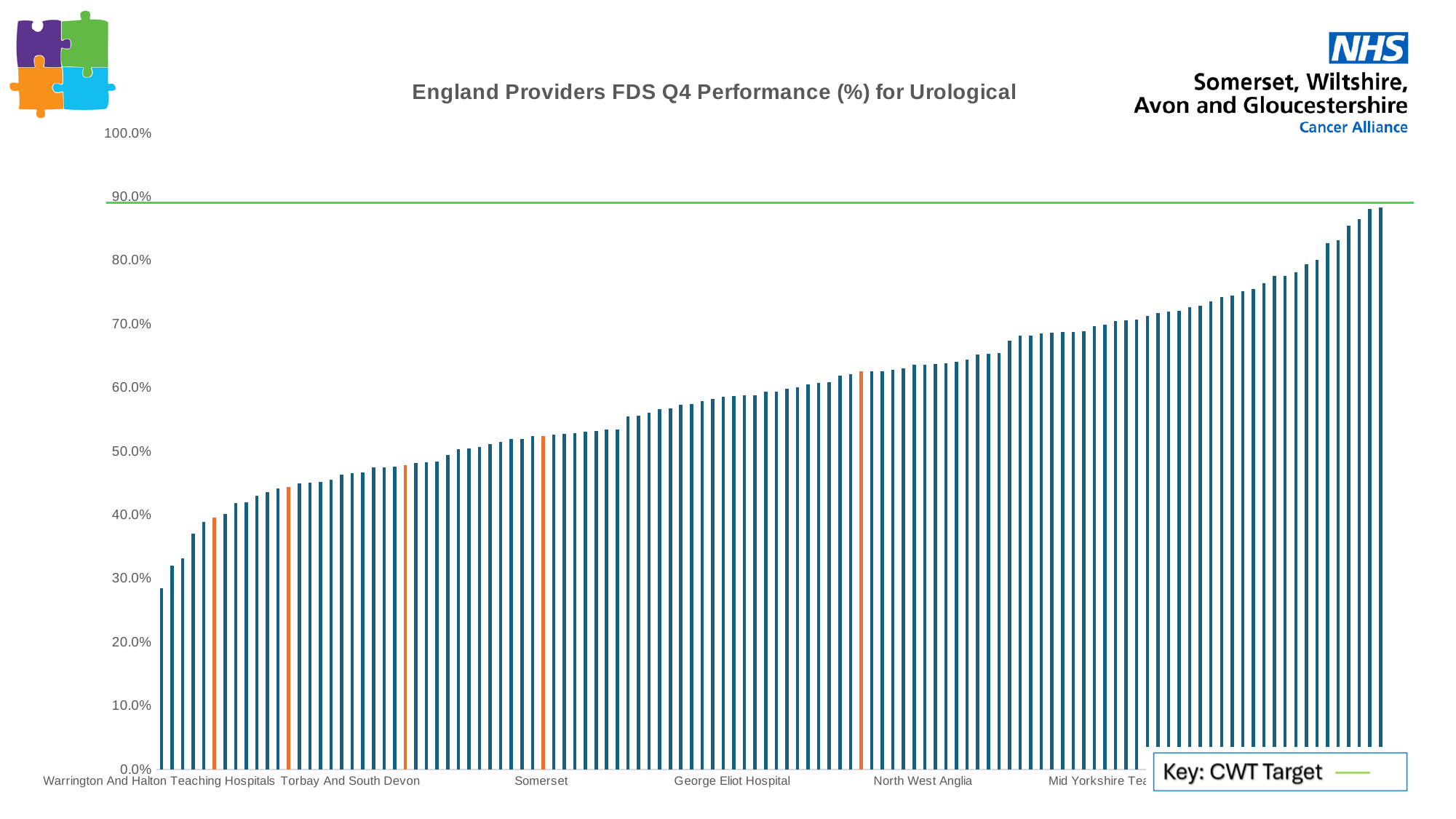
What colour is the CWT Target line in the key? green Is the value for North West Anglia greater or less than 60.0%? greater Do the bar values rise or fall from left to right along the x axis? rise What kind of chart is shown on the slide? bar chart What is the title of the chart? England Providers FDS Q4 Performance (%) for Urological Is the value for George Eliot Hospital greater or less than 50.0%? greater Does any provider's bar reach the CWT Target line? No Which has the larger value, Warrington And Halton Teaching Hospitals or North West Anglia? North West Anglia At what value on the y axis does the CWT Target line sit? 90.0%